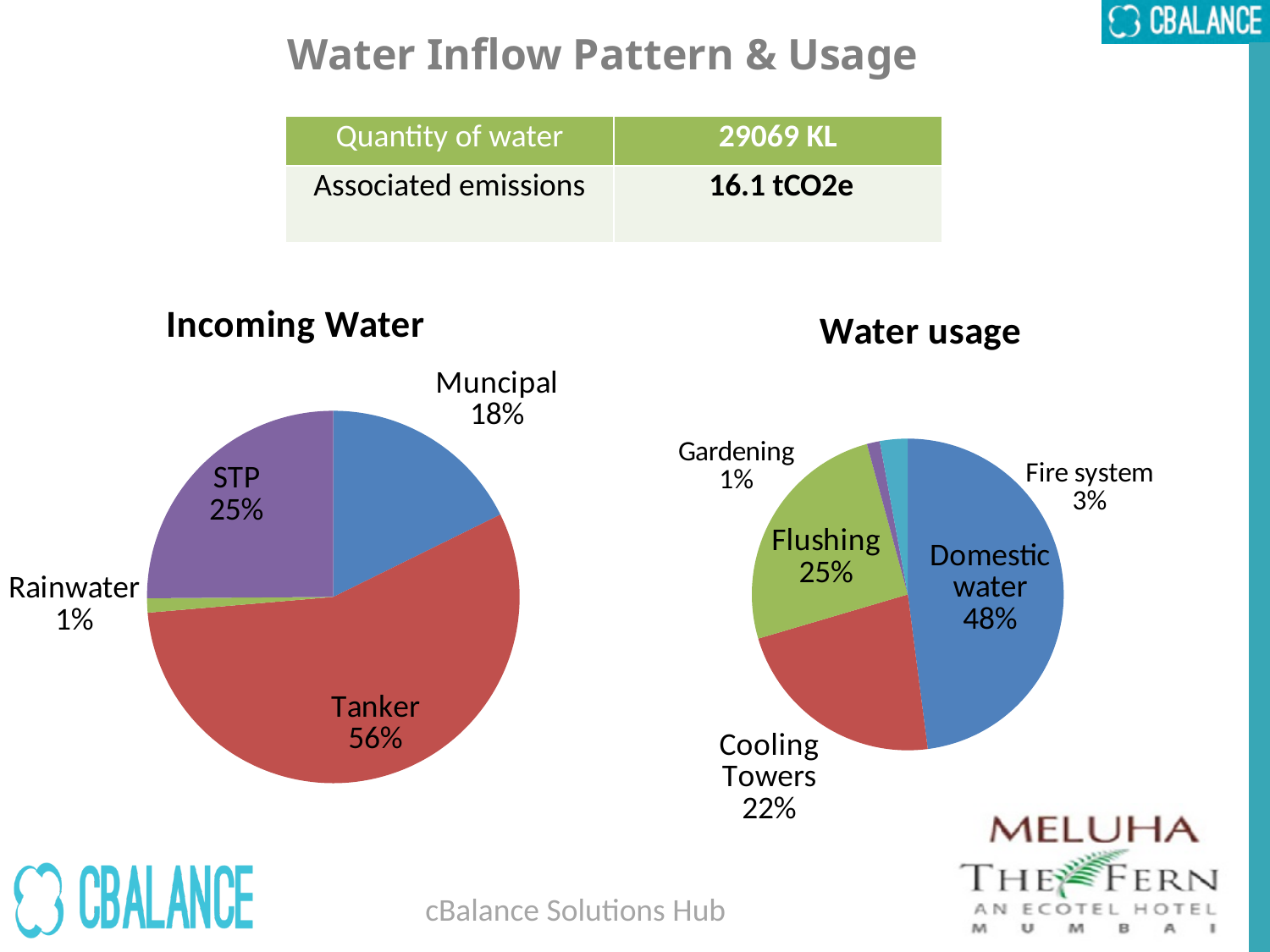
In the Water usage chart, which use has the largest share? Domestic water In the Incoming Water chart, how many sources are shown? 4 In the Incoming Water chart, which source has the largest share? Tanker In the Incoming Water chart, which source has the smallest share? Rainwater What type of chart is the Water usage chart? Pie chart In the Water usage chart, what share does Domestic water account for? 48% In the Incoming Water chart, what share does STP account for? 25% In the Water usage chart, which is larger, Flushing or Cooling Towers? Flushing In the Incoming Water chart, what share does Tanker account for? 56% In the Water usage chart, which use has the smallest share? Gardening In the Incoming Water chart, what is the difference in percentage points between Tanker and Muncipal? 38 In the Water usage chart, what share do Cooling Towers account for? 22%